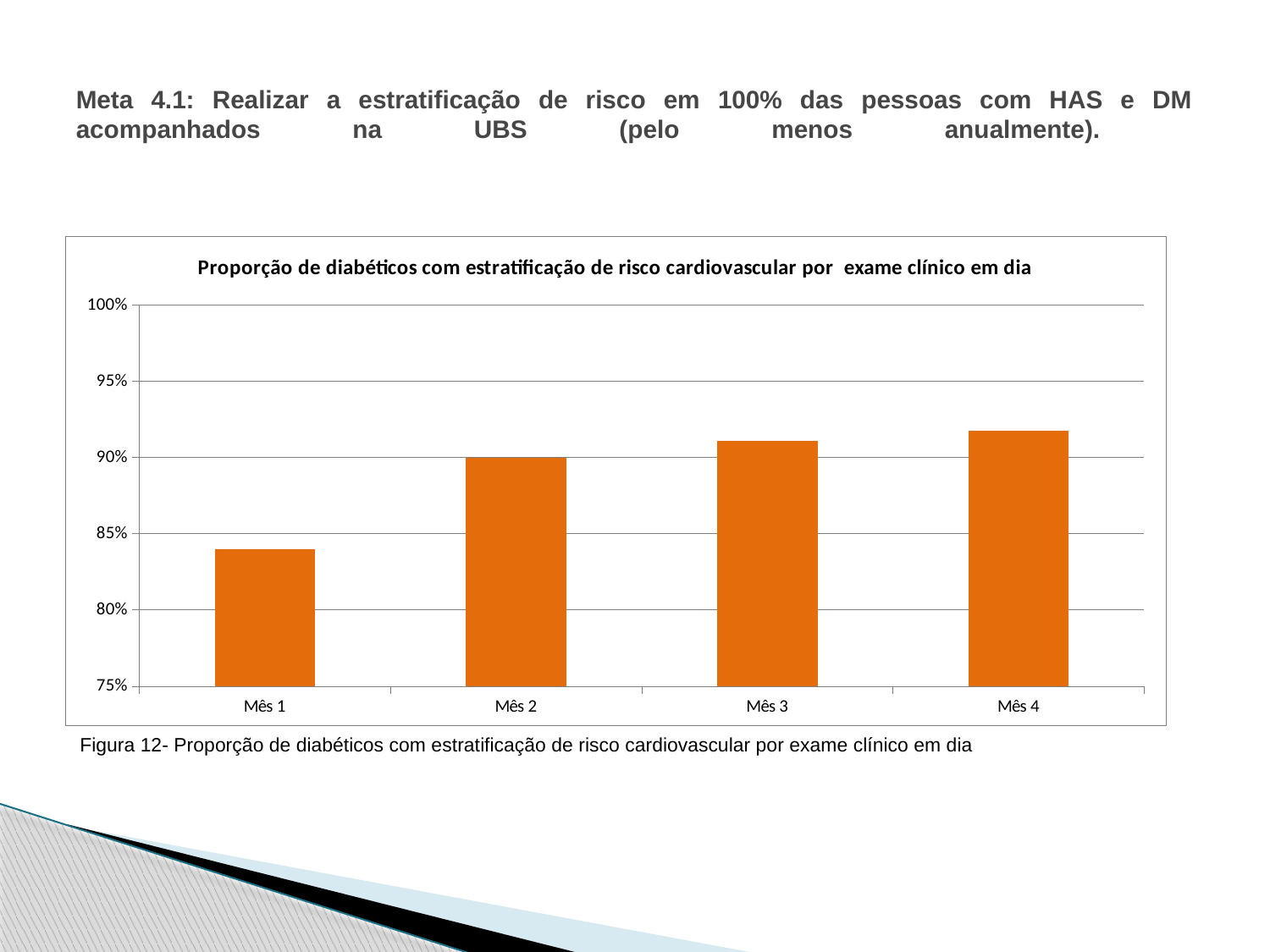
Is the value for Mês 1 greater or less than 85%? less Which is larger, the value for Mês 1 or the value for Mês 2? Mês 2 Which month has the highest proportion of diabetics with cardiovascular risk stratification? Mês 4 Is the value for Mês 4 greater or less than 95%? less Do the values rise or fall from Mês 1 to Mês 4? rise What kind of chart is shown on the slide? bar chart How many months (categories) are plotted in the chart? 4 Is the value for Mês 3 greater or less than 90%? greater Which month has the lowest proportion of diabetics with cardiovascular risk stratification? Mês 1 What is the title of the chart? Proporção de diabéticos com estratificação de risco cardiovascular por exame clínico em dia What colour are the bars in the chart? orange